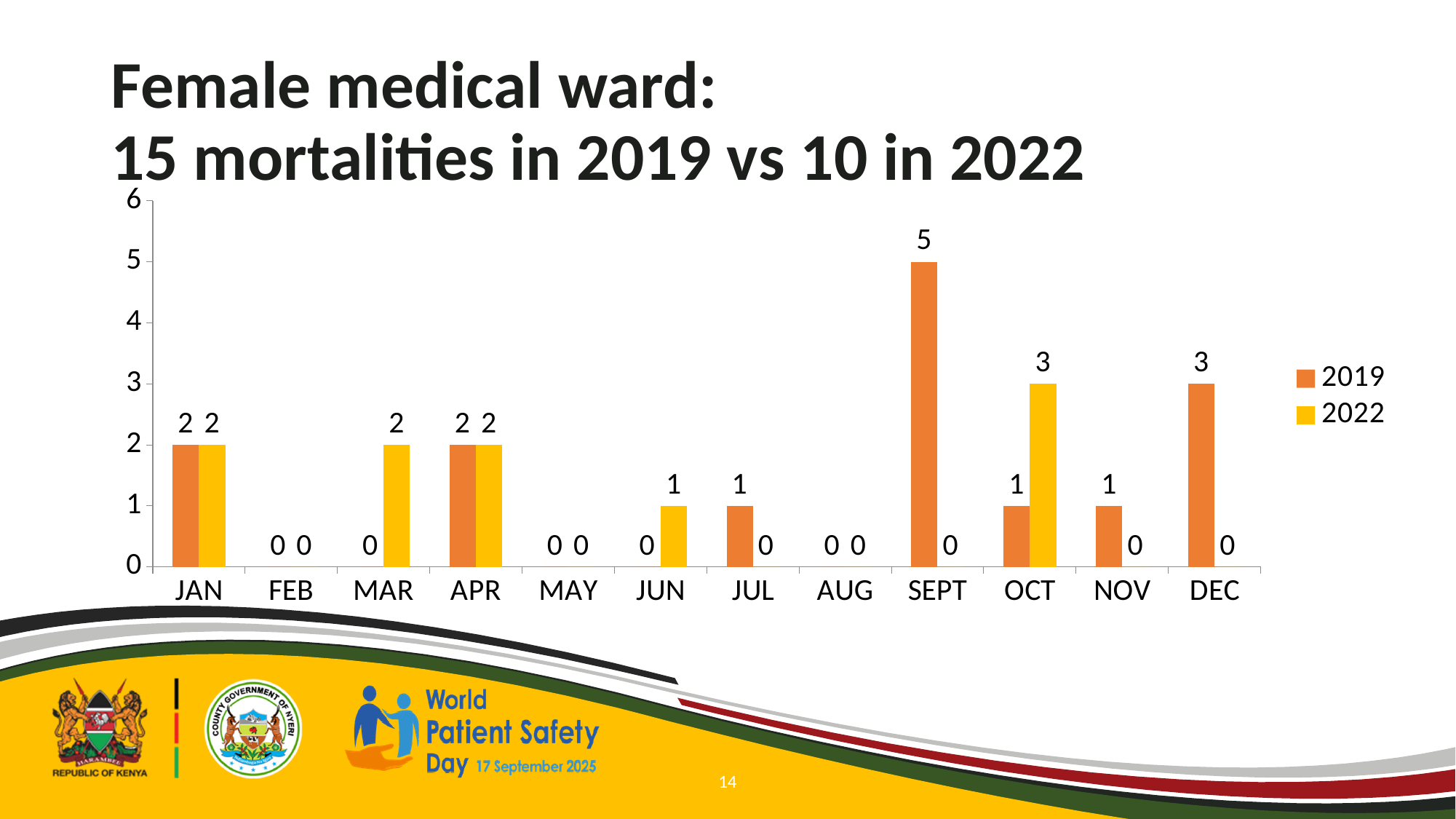
What kind of chart is shown on the slide? bar chart Which is larger in OCT, the 2019 value or the 2022 value? 2022 Which month has the highest value for 2022? OCT Which month has the highest value for 2019? SEPT Which series is shown in yellow in the legend? 2022 What is the value for 2022 in MAR? 2 How many series does the legend list? 2 What is the value for 2019 in SEPT? 5 What is the value for 2022 in OCT? 3 What is the value for 2019 in DEC? 3 What is the difference between the 2019 and 2022 values in SEPT? 5 How many months are shown on the x axis? 12